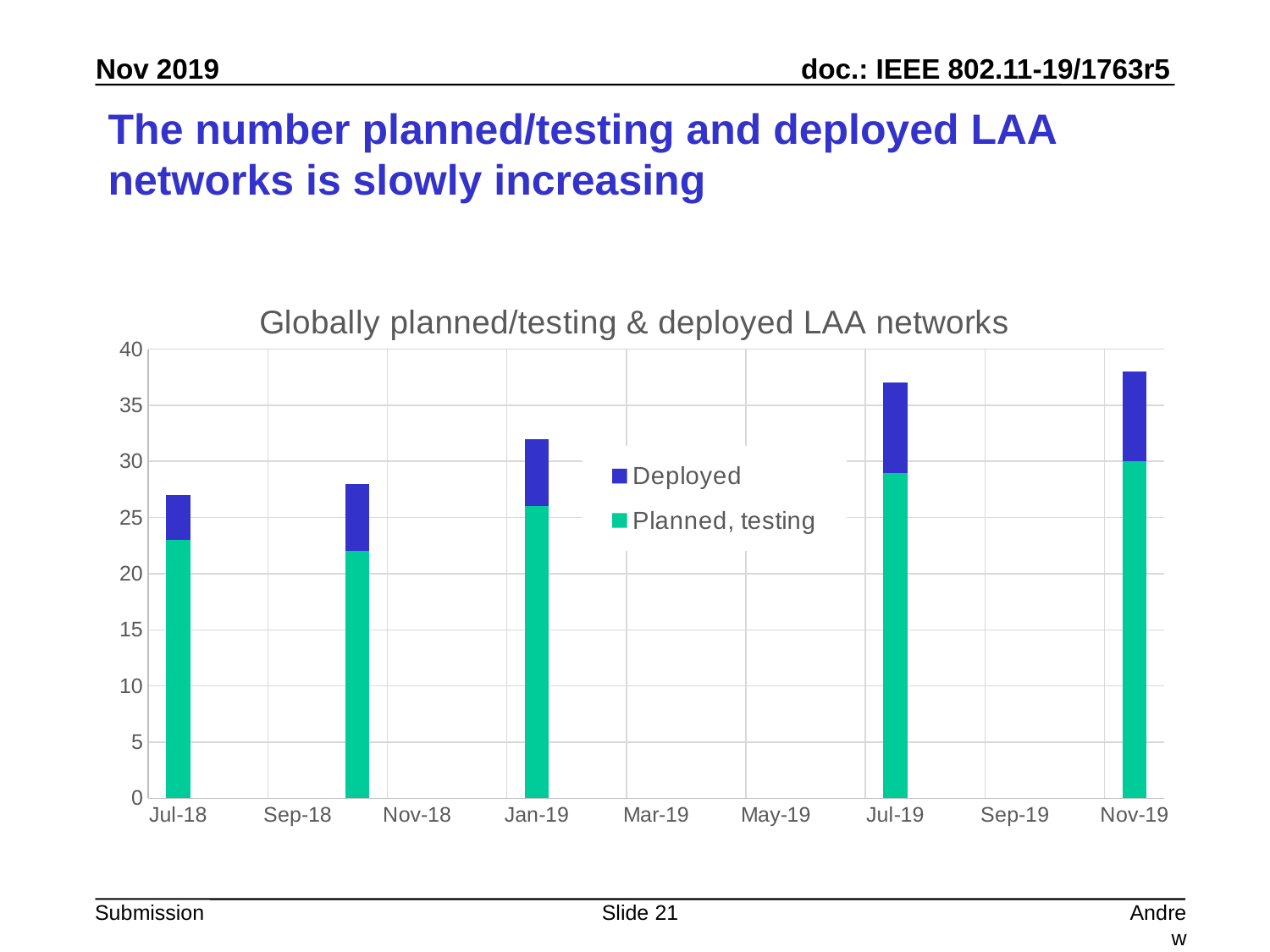
What is the title of the chart? Globally planned/testing & deployed LAA networks How many bars are plotted in the chart? 5 Is the total height of the Jul-19 bar greater or less than 35? greater Which series is shown in green? Planned, testing What kind of chart is shown on the slide? stacked bar chart Which bar is taller in total, Jul-18 or Jan-19? Jan-19 Is the total height of the Jan-19 bar greater or less than 35? less Do the total bar heights generally rise or fall from Jul-18 to Nov-19? rise How many series does the legend list? 2 Which bar is taller in total, Jan-19 or Jul-19? Jul-19 Is the total height of the Jul-18 bar greater or less than 25? greater